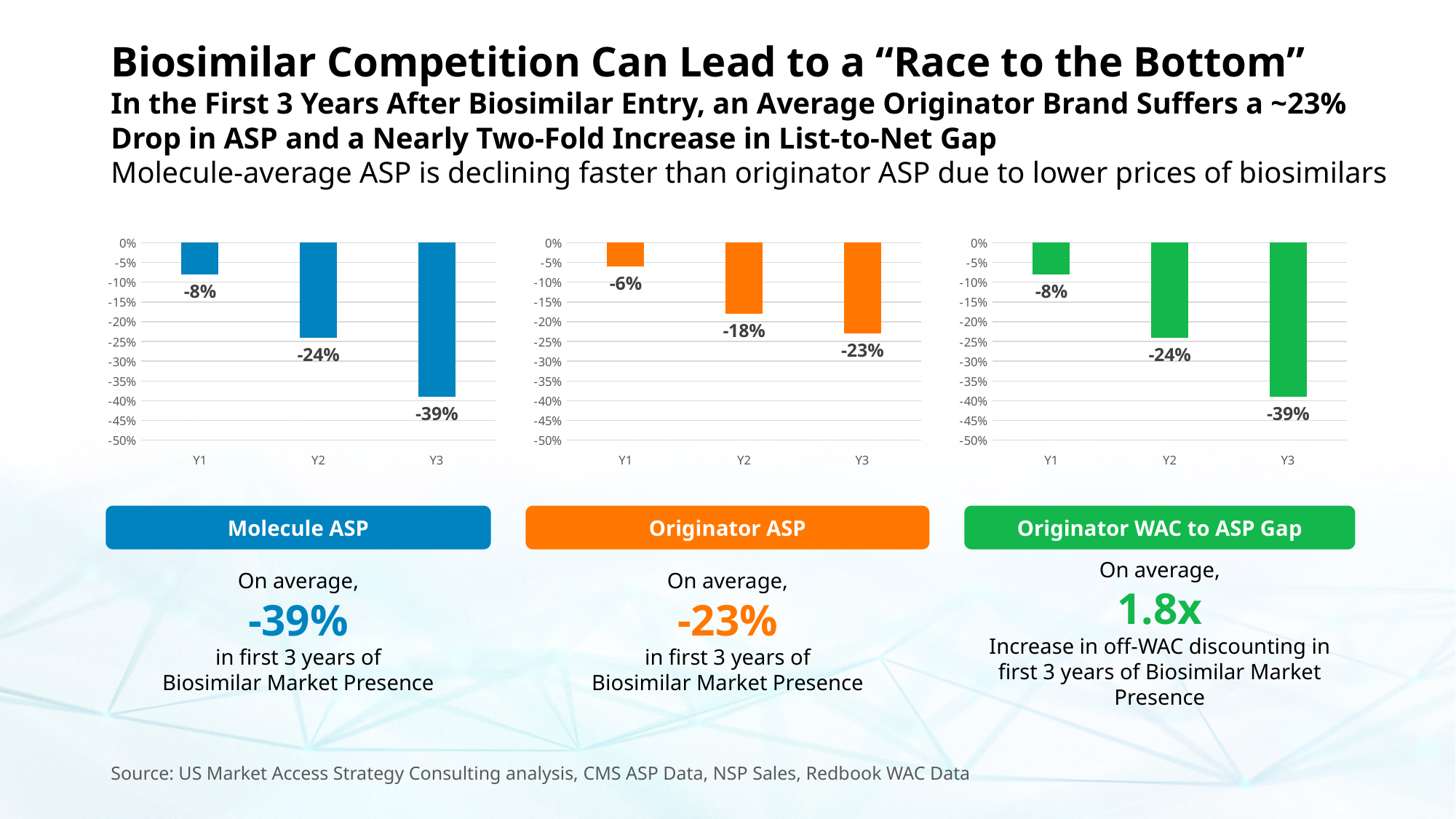
In the Originator WAC to ASP Gap chart, what is the value for Y3? -39% What colour are the bars in the Originator ASP chart? orange In the Originator ASP chart, what is the value for Y1? -6% In the Molecule ASP chart, which year has the highest value? Y1 In the Molecule ASP chart, what is the value for Y2? -24% In the Originator ASP chart, which year has the lowest value? Y3 What kind of chart is the Molecule ASP chart? bar chart In the Molecule ASP chart, what is the difference between the Y2 and Y3 values? 15 percentage points In the Originator ASP chart, is the value for Y2 larger or smaller than the value for Y3? larger How many years are shown on the x axis of the Originator WAC to ASP Gap chart? 3 In the Originator ASP chart, what is the difference between the Y1 and Y3 values? 17 percentage points In the Originator ASP chart, do the values rise or fall from Y1 to Y3? fall